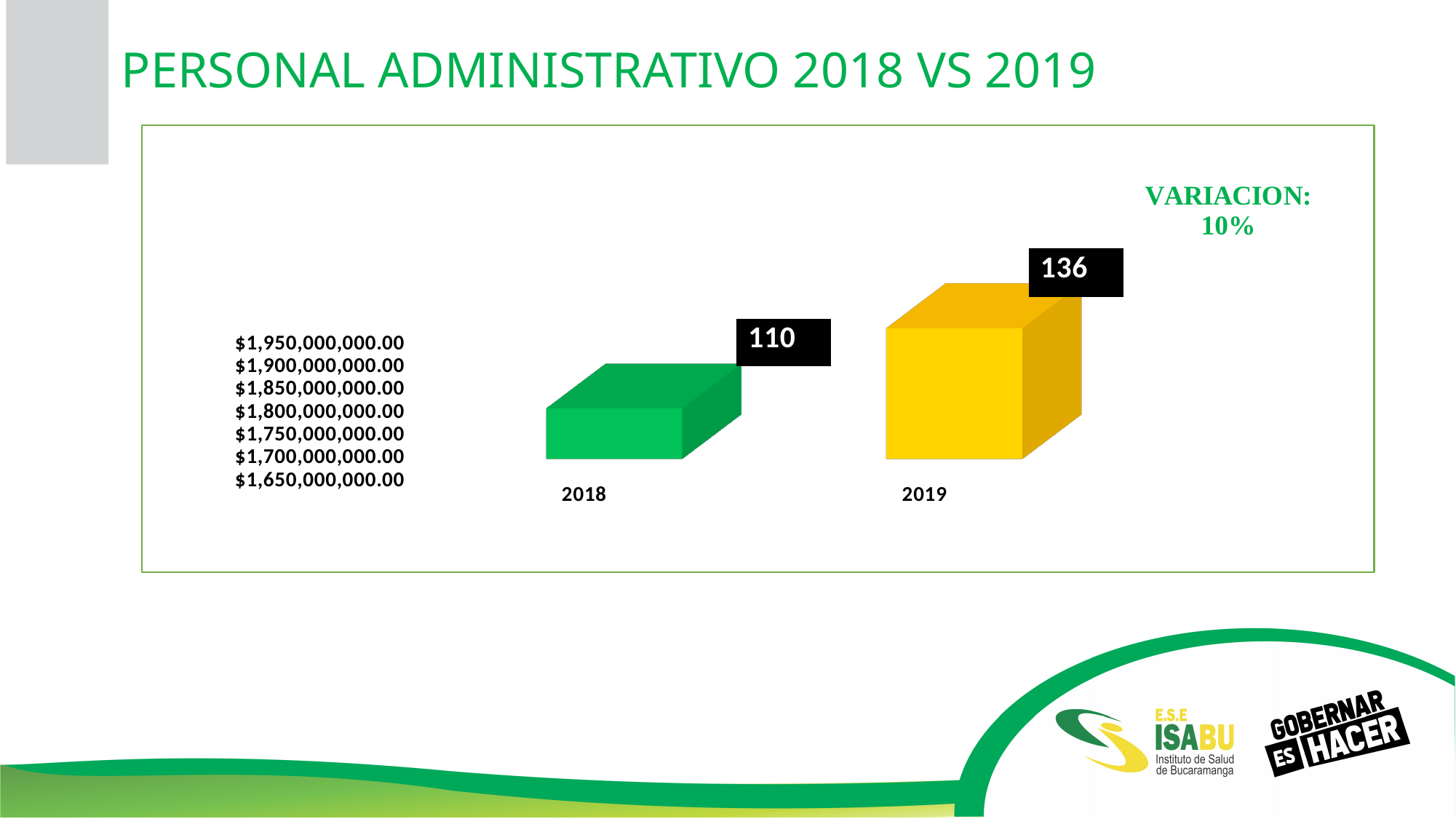
Is the labelled value for 2019 larger or smaller than the labelled value for 2018? larger Which year has the higher bar in the chart? 2019 Do the values rise or fall from 2018 to 2019? rise Which year has the lower bar in the chart? 2018 What is the data label shown on the bar for 2019? 136 What colour is the bar for 2019? yellow How many years (categories) are plotted in the chart? 2 What variation percentage is stated on the slide? 10% What kind of chart is shown on the slide? bar chart What is the data label shown on the bar for 2018? 110 What is the difference between the labelled values for 2019 and 2018? 26